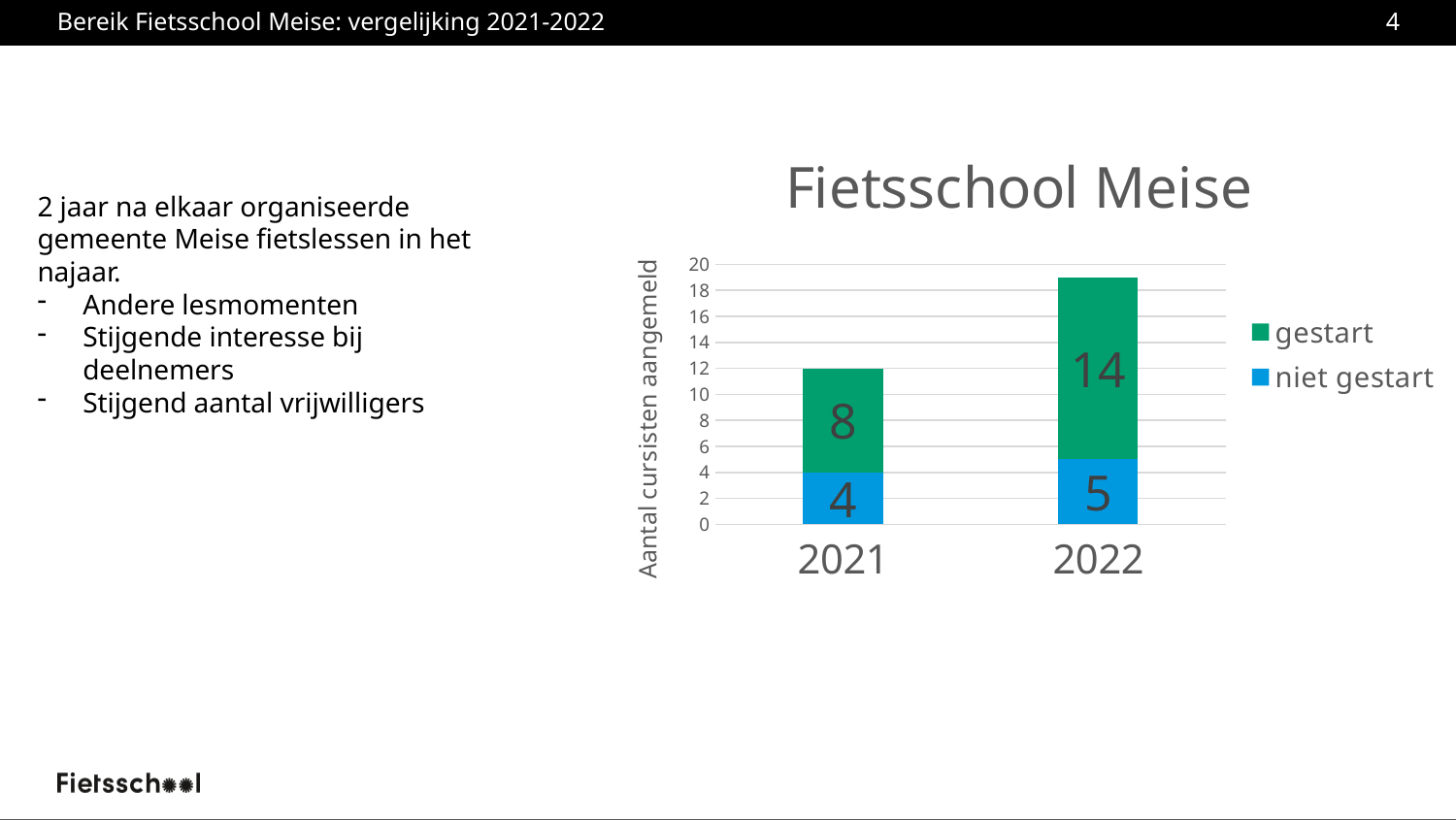
What is the value for 'niet gestart' in 2022? 5 What is the title of the chart? Fietsschool Meise What is the value for 'gestart' in 2021? 8 Which year has the higher 'gestart' value, 2021 or 2022? 2022 How many categories are shown on the x axis? 2 What is the total of the stacked bar for 2021? 12 What is the value for 'gestart' in 2022? 14 What is the difference between the 'gestart' values for 2022 and 2021? 6 What is the total of the stacked bar for 2022? 19 What is the value for 'niet gestart' in 2021? 4 How many series does the legend list? 2 What kind of chart is shown? Stacked bar chart